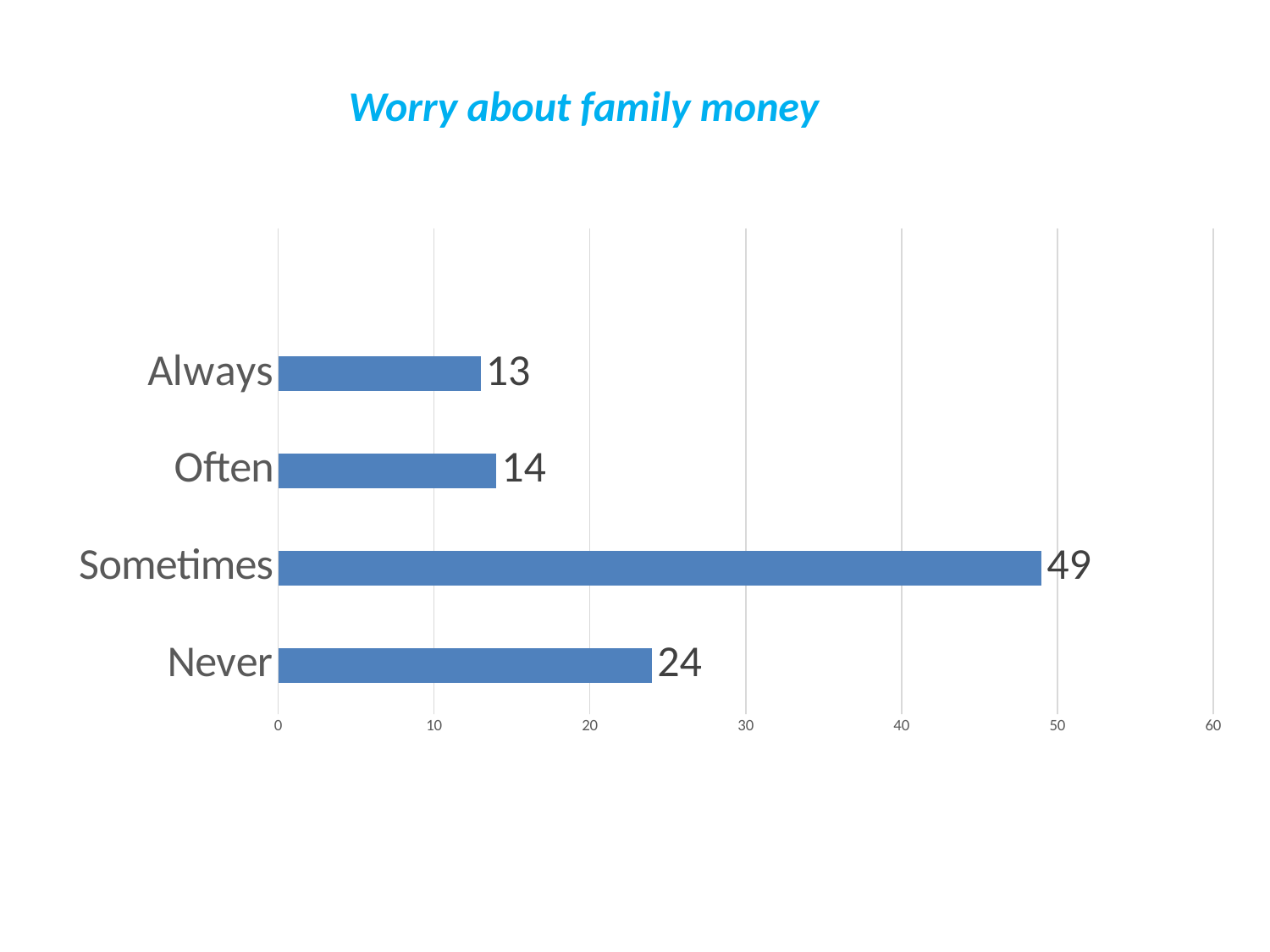
What is the difference between the values for Sometimes and Never? 25 What is the value for Never? 24 How many categories are shown in the chart? 4 Which is larger, the value for Never or the value for Often? Never Which category has the lowest value? Always Which category has the highest value? Sometimes What is the value for Sometimes? 49 What kind of chart is shown on the slide? bar chart What is the value for Often? 14 What is the value for Always? 13 Is the value for Sometimes greater or less than 40? greater What is the difference between the values for Often and Always? 1